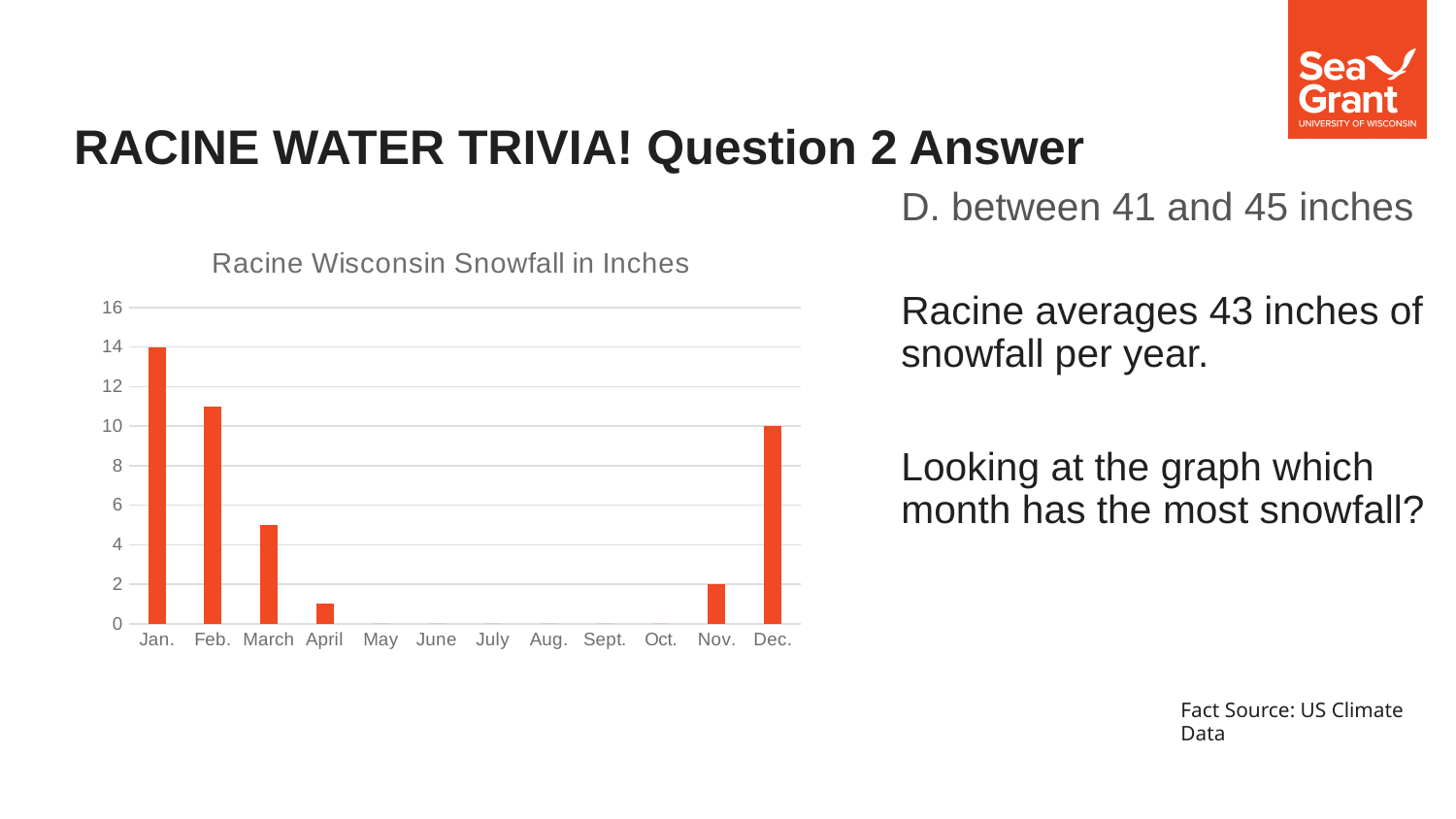
Is the value for March greater or less than 4? greater Is the value for Feb. greater or less than 10? greater How many months are shown on the x axis of the chart? 12 What is the snowfall value for Dec. in the chart? 10 Is the value for April greater or less than 2? less What is the difference in snowfall between Jan. and Dec.? 4 What is the snowfall value for Nov. in the chart? 2 Which has a larger snowfall value, Jan. or Dec.? Jan. Which has a larger snowfall value, March or Nov.? March What is the snowfall value for Jan. in the chart? 14 Which month has the highest snowfall in the chart? Jan. What kind of chart is shown on the slide? Bar chart